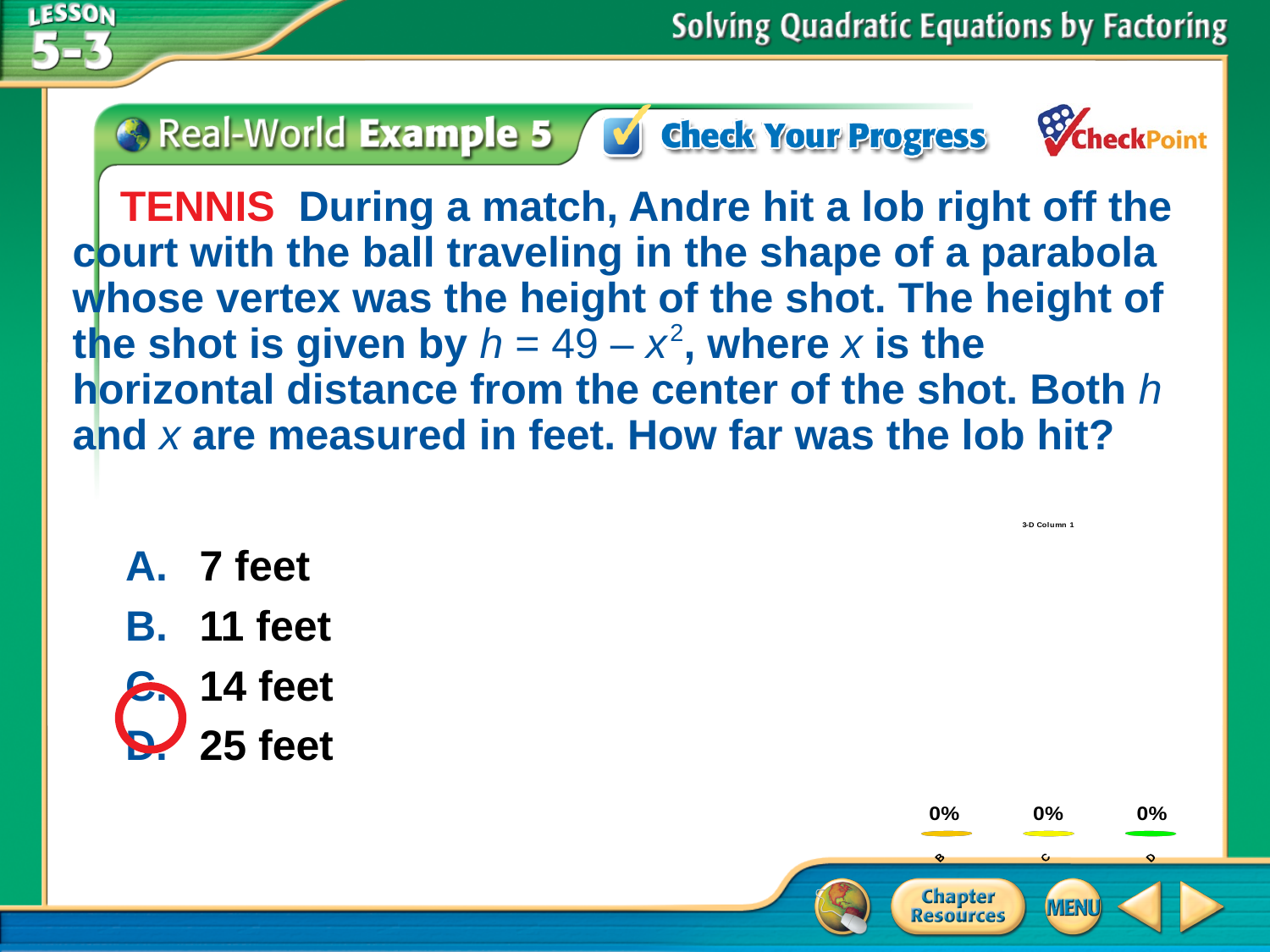
What is the value shown above the leftmost bar in the chart at the bottom right of the slide? 0% What is the difference between the values of the leftmost and rightmost bars in the chart at the bottom right of the slide? 0% What is the value shown above the middle bar in the chart at the bottom right of the slide? 0% What is the title printed above the chart at the bottom right of the slide? 3-D Column 1 What is the value shown above the rightmost bar in the chart at the bottom right of the slide? 0% What colour is the base of the rightmost bar in the chart at the bottom right of the slide? green Do the values in the chart at the bottom right of the slide rise, fall, or stay the same from left to right? stay the same What kind of chart is shown at the bottom right of the slide? bar chart How many bars does the chart at the bottom right of the slide have? 3